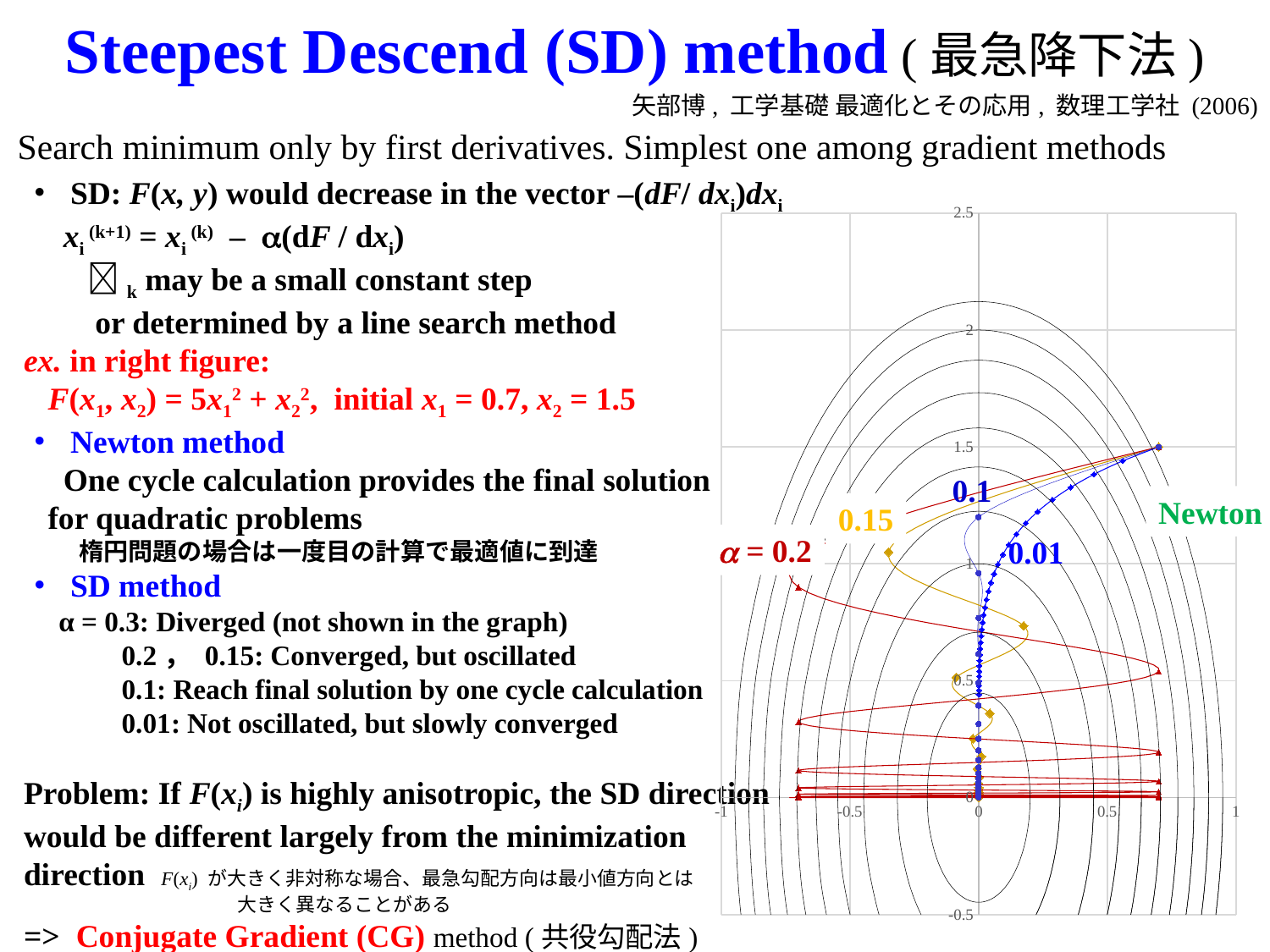
What is the lowest tick value shown on the x axis of the chart? -1 What is the lowest tick value shown on the y axis of the chart? -0.5 What kind of chart is shown on the right of the slide? line chart Toward which point do the trajectories on the chart converge? (0, 0) What colour is the α = 0.01 trajectory on the chart? blue Is the leftmost x value reached by the α = 0.2 trajectory greater or less than -0.5? less At which point do all the trajectories on the chart start? (0.7, 1.5) What is the highest tick value shown on the y axis of the chart? 2.5 What colour is the α = 0.15 trajectory on the chart? gold Which labelled trajectory oscillates most widely across the x axis? α = 0.2 How many labelled trajectories are drawn on the chart? 5 Is the starting y value of the trajectories greater or less than 1? greater